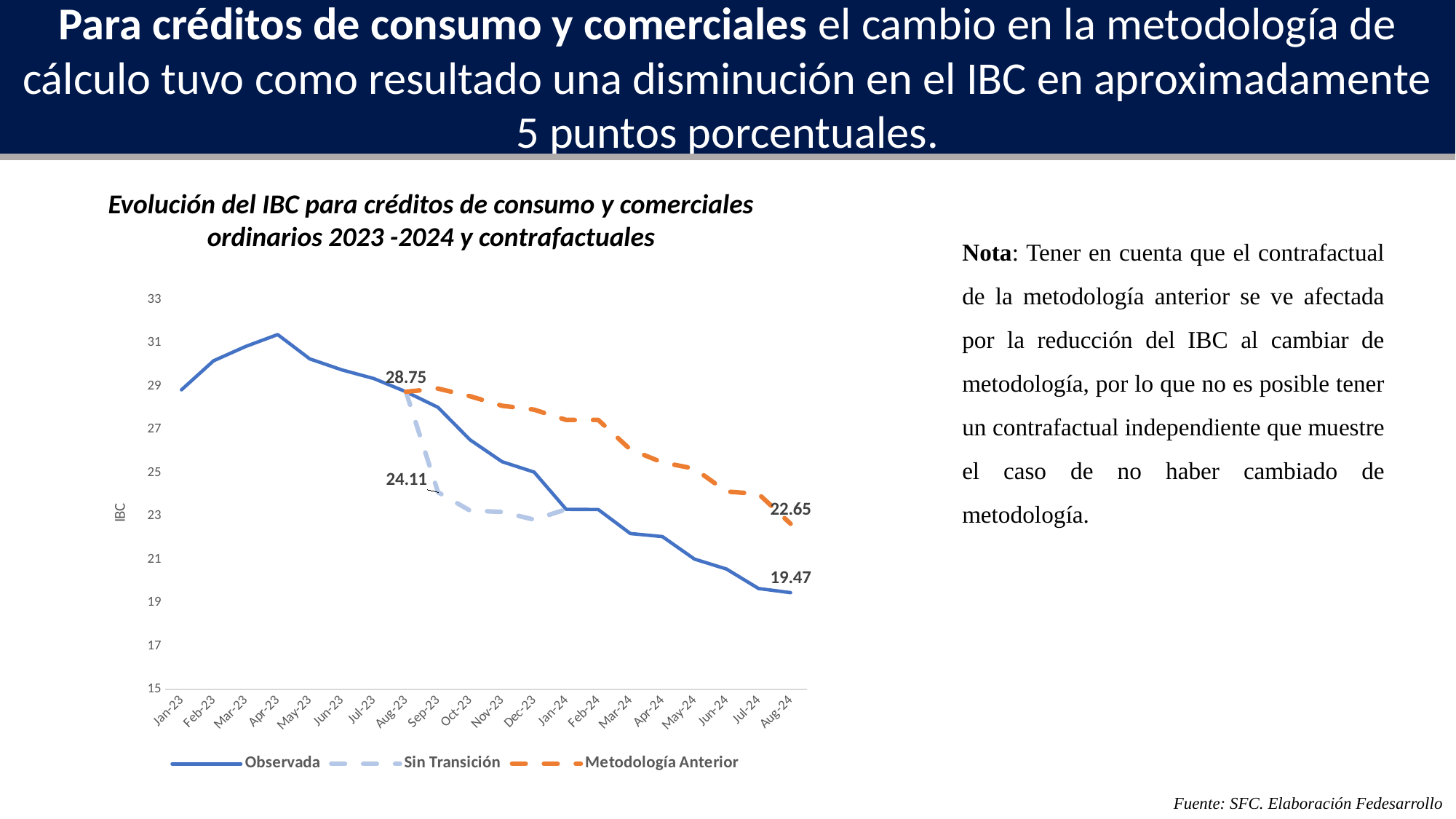
In Aug-24, which series has the higher value: Observada or Metodología Anterior? Metodología Anterior What is the difference between the Metodología Anterior and Observada values in Aug-24? 3.18 What is the value of the Metodología Anterior series in Aug-24? 22.65 Is the value of the Observada series in Jan-24 greater or less than 25? less Does the Observada series rise or fall from Aug-23 to Aug-24? fall What value is labelled at Aug-23 where the Metodología Anterior series begins? 28.75 What value is labelled on the Sin Transición series in Sep-23? 24.11 How many series does the legend list? 3 What is the value of the Observada series in Aug-24? 19.47 What type of chart is shown on the slide? line chart What is the label on the y axis? IBC How many months are shown on the x axis? 20